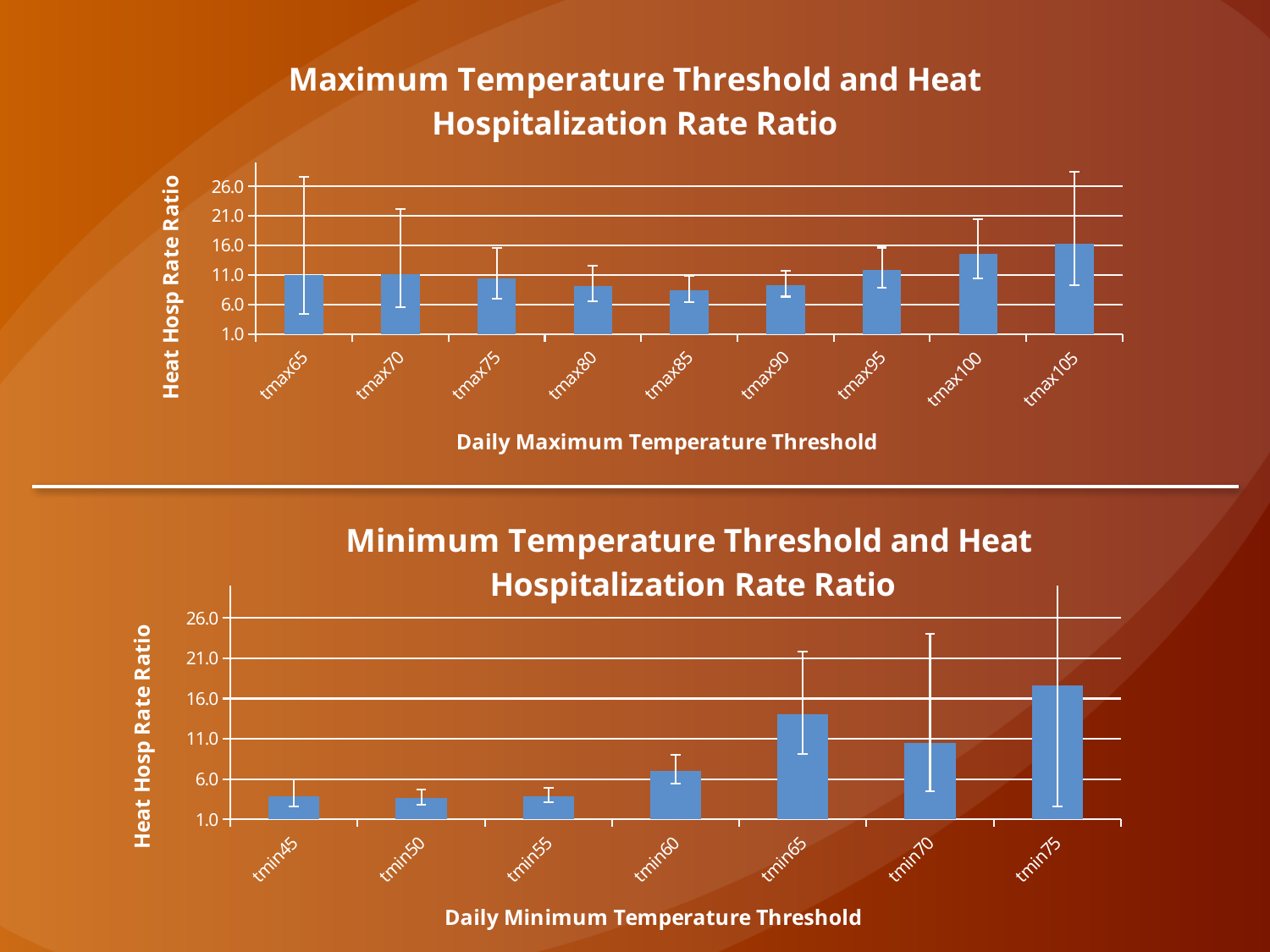
In the "Maximum Temperature Threshold and Heat Hospitalization Rate Ratio" chart, which threshold has the highest rate ratio? tmax105 How many temperature threshold categories are plotted in the "Maximum Temperature Threshold and Heat Hospitalization Rate Ratio" chart? 9 In the "Maximum Temperature Threshold and Heat Hospitalization Rate Ratio" chart, which has the larger rate ratio, tmax65 or tmax105? tmax105 In the "Minimum Temperature Threshold and Heat Hospitalization Rate Ratio" chart, which threshold has the highest rate ratio? tmin75 What kind of chart is the "Maximum Temperature Threshold and Heat Hospitalization Rate Ratio" chart? bar chart What is the y-axis title of the "Minimum Temperature Threshold and Heat Hospitalization Rate Ratio" chart? Heat Hosp Rate Ratio In the "Maximum Temperature Threshold and Heat Hospitalization Rate Ratio" chart, is the value for tmax85 greater or less than 11.0? less In the "Minimum Temperature Threshold and Heat Hospitalization Rate Ratio" chart, is the value for tmin65 greater or less than 11.0? greater In the "Minimum Temperature Threshold and Heat Hospitalization Rate Ratio" chart, which has the larger rate ratio, tmin65 or tmin70? tmin65 In the "Minimum Temperature Threshold and Heat Hospitalization Rate Ratio" chart, is the value for tmin45 greater or less than 6.0? less How many temperature threshold categories are plotted in the "Minimum Temperature Threshold and Heat Hospitalization Rate Ratio" chart? 7